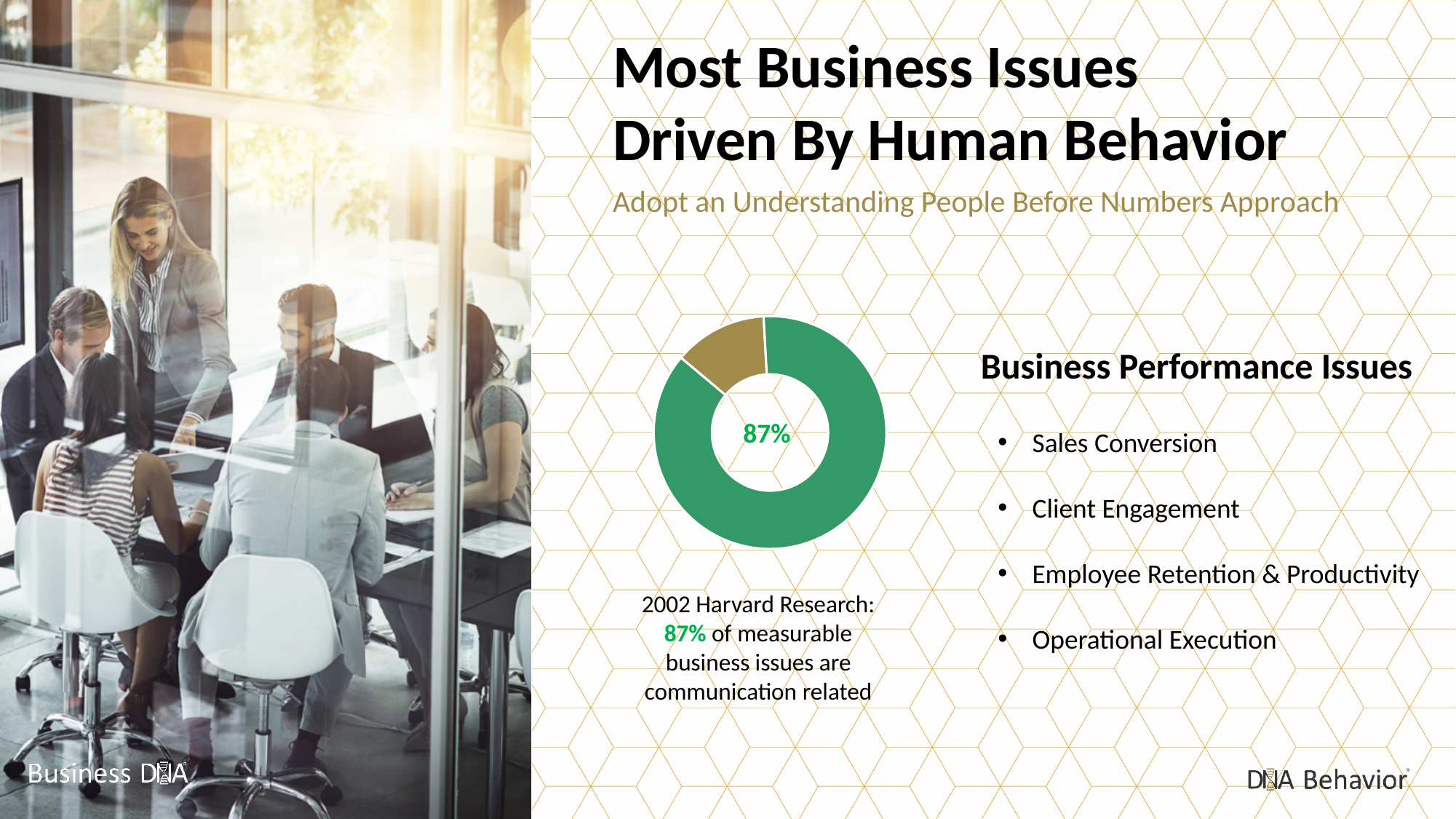
Is the green slice of the donut chart greater or less than 50% of the whole? greater According to the caption under the donut chart, what does the 87% represent? measurable business issues that are communication related What percentage does the green slice of the donut chart represent? 87% What value is printed in the centre of the donut chart? 87% How many slices does the donut chart have? 2 What year of Harvard research is cited in the caption below the donut chart? 2002 What share of the donut chart does the gold slice represent? 13% Which colour slice is the smallest in the donut chart? gold Which colour slice is the largest in the donut chart? green Which slice of the donut chart is larger, the green one or the gold one? green What kind of chart is shown on the slide? pie chart (donut)